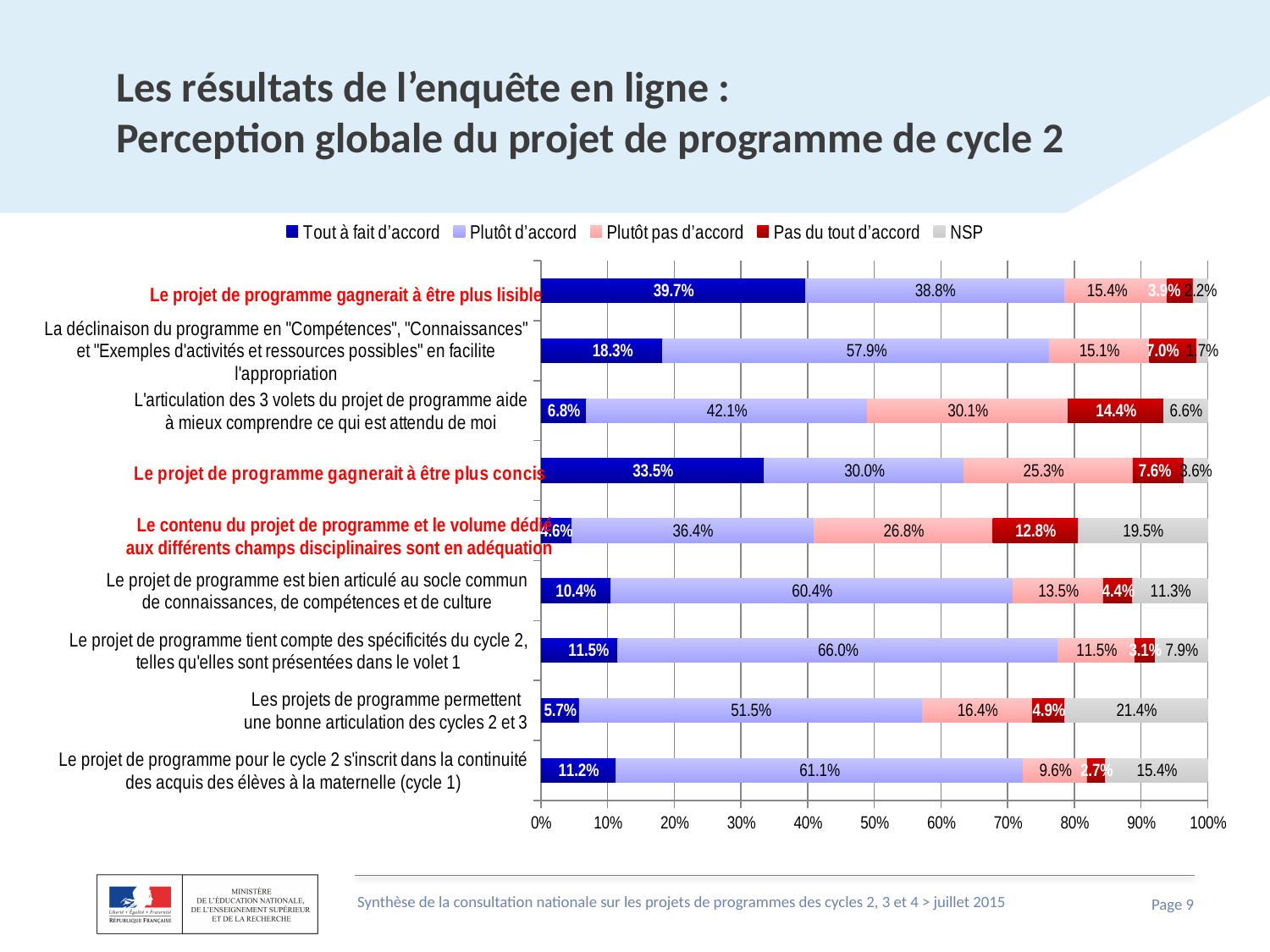
Which statement has the lowest 'Plutôt d'accord' value? Le projet de programme gagnerait à être plus concis What is the 'Plutôt d'accord' value for 'Le projet de programme tient compte des spécificités du cycle 2, telles qu'elles sont présentées dans le volet 1'? 66.0% What is the difference between the 'Plutôt pas d'accord' values for 'L'articulation des 3 volets du projet de programme aide à mieux comprendre ce qui est attendu de moi' and 'Le projet de programme gagnerait à être plus concis'? 4.8% What is the 'NSP' value for 'Les projets de programme permettent une bonne articulation des cycles 2 et 3'? 21.4% What is the 'Pas du tout d'accord' value for 'L'articulation des 3 volets du projet de programme aide à mieux comprendre ce qui est attendu de moi'? 14.4% What kind of chart is shown on the slide? Stacked bar chart How many series does the legend list? 5 What is the 'Tout à fait d'accord' value for 'Le projet de programme gagnerait à être plus lisible'? 39.7% Which is larger: the 'NSP' value for 'Le contenu du projet de programme et le volume dédié aux différents champs disciplinaires sont en adéquation' or the 'NSP' value for 'Le projet de programme pour le cycle 2 s'inscrit dans la continuité des acquis des élèves à la maternelle (cycle 1)'? Le contenu du projet de programme et le volume dédié aux différents champs disciplinaires sont en adéquation Which statement has the highest 'Tout à fait d'accord' value? Le projet de programme gagnerait à être plus lisible Which legend entry is shown in dark blue? Tout à fait d'accord How many statements (categories) are plotted on the chart? 9